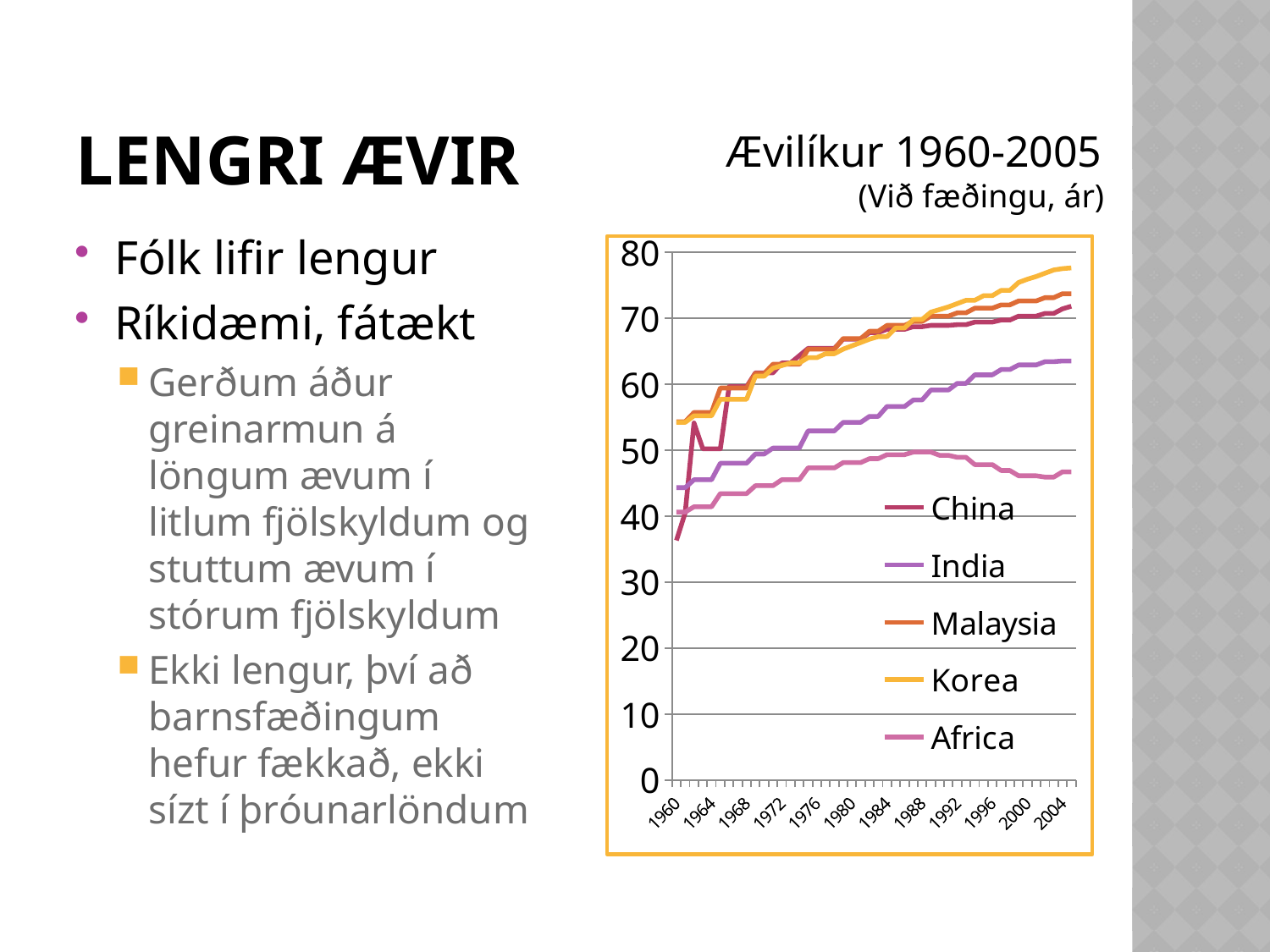
Is the value for Africa in 2004 greater or less than 50? less What is the title of the chart? Ævilíkur 1960-2005 (Við fæðingu, ár) How many series does the legend list? 5 Which series has the lowest value in 2004? Africa Which series has the highest value in 2004? Korea Is the value for Korea in 2004 greater or less than 70? greater Does the India line rise or fall from 1960 to 2004? rise In 2004, which is larger, the value for India or the value for Africa? India Which series is shown with a yellow line? Korea Is the value for China in 1960 greater or less than 40? less What kind of chart is shown on the slide? line chart